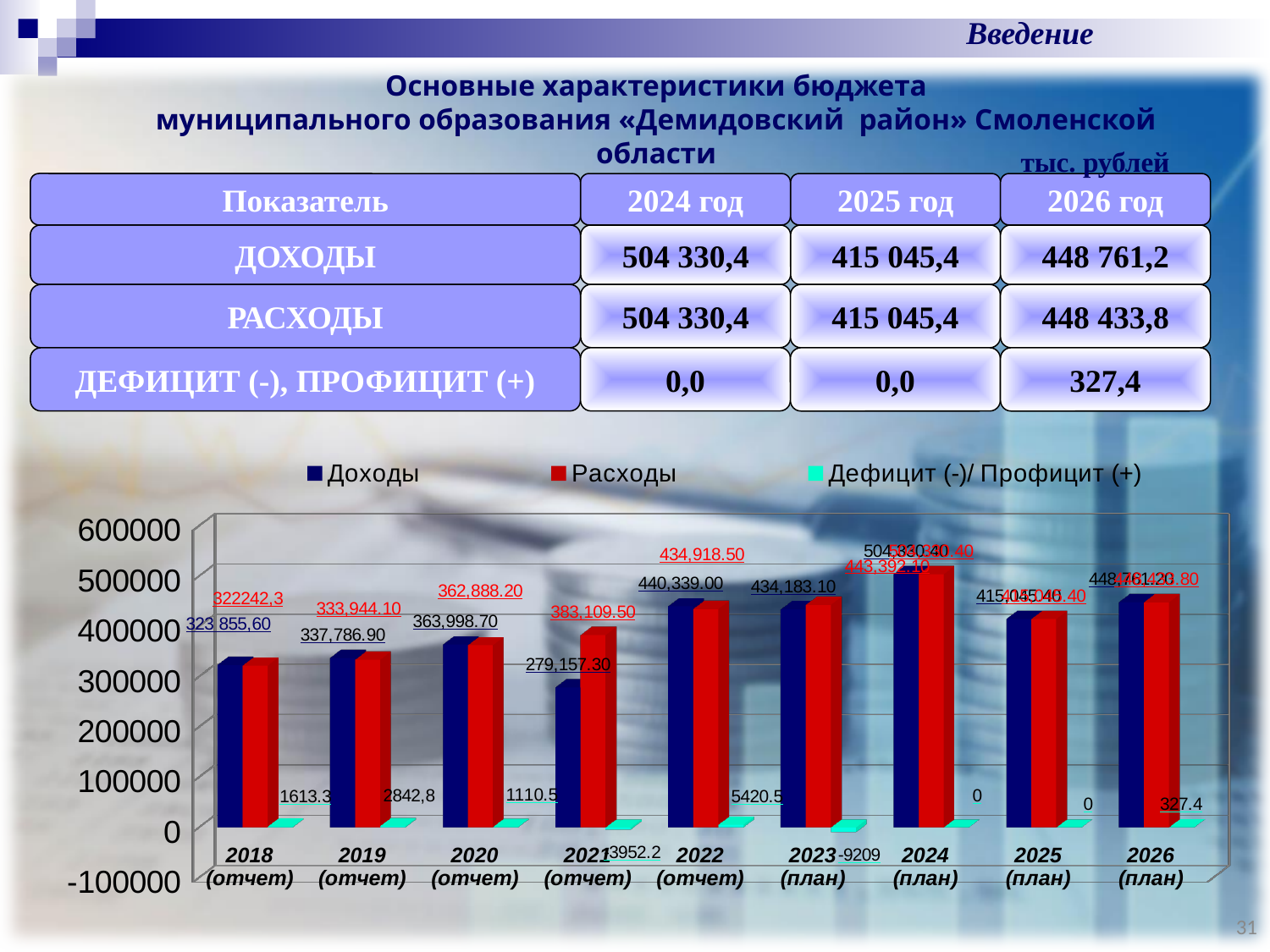
What is the value of Расходы for 2021 (отчет) in the chart? 383,109.50 What is the value of Дефицит (-)/ Профицит (+) for 2022 (отчет) in the chart? 5420.5 What kind of chart is shown on the slide? bar chart In which year is Доходы highest in the chart? 2024 (план) Is the value of Доходы for 2018 (отчет) greater or less than 400000? less In which year is Доходы lowest in the chart? 2021 (отчет) How many series does the chart legend list? 3 How many year categories are shown along the x axis of the chart? 9 What colour represents Расходы in the chart legend? red What is the value of Доходы for 2020 (отчет) in the chart? 363,998.70 What is the value of Доходы for 2022 (отчет) in the chart? 440,339.00 For 2021 (отчет), which is larger in the chart: Доходы or Расходы? Расходы